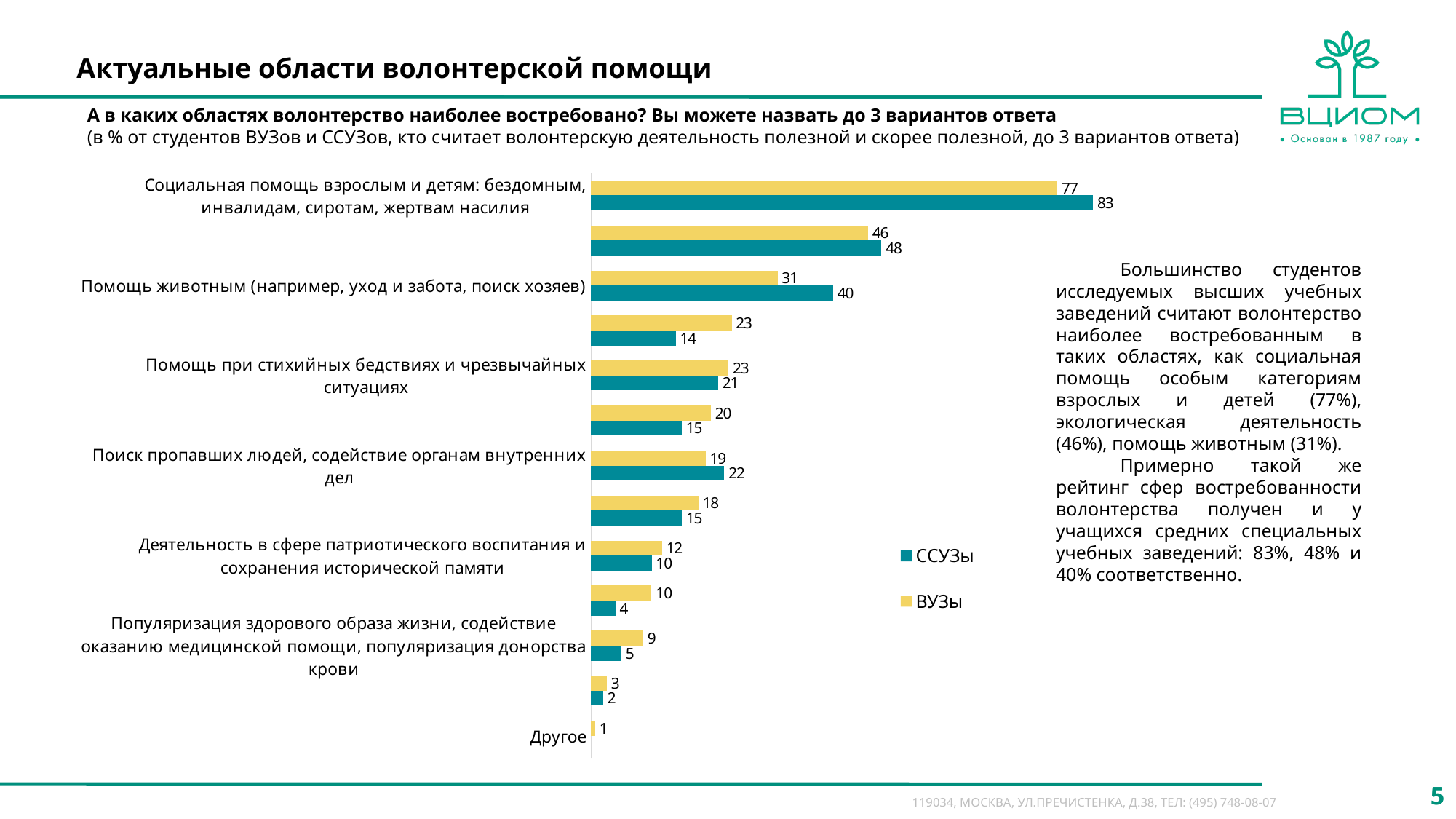
How many series does the legend list? 2 What is the value for ВУЗы for "Социальная помощь взрослым и детям: бездомным, инвалидам, сиротам, жертвам насилия"? 77 What is the value for ВУЗы for "Помощь животным (например, уход и забота, поиск хозяев)"? 31 For "Популяризация здорового образа жизни, содействие оказанию медицинской помощи, популяризация донорства крови", which is larger: the ВУЗы value or the ССУЗы value? ВУЗы What is the value for ВУЗы for "Другое"? 1 What is the value for ССУЗы for "Помощь животным (например, уход и забота, поиск хозяев)"? 40 What kind of chart is shown on the slide? Bar chart What is the difference between the ССУЗы and ВУЗы values for "Помощь животным (например, уход и забота, поиск хозяев)"? 9 Which category has the highest value for ССУЗы? Социальная помощь взрослым и детям: бездомным, инвалидам, сиротам, жертвам насилия For "Поиск пропавших людей, содействие органам внутренних дел", which is larger: the ССУЗы value or the ВУЗы value? ССУЗы What is the value for ССУЗы for "Социальная помощь взрослым и детям: бездомным, инвалидам, сиротам, жертвам насилия"? 83 Which series is shown in yellow in the legend? ВУЗы